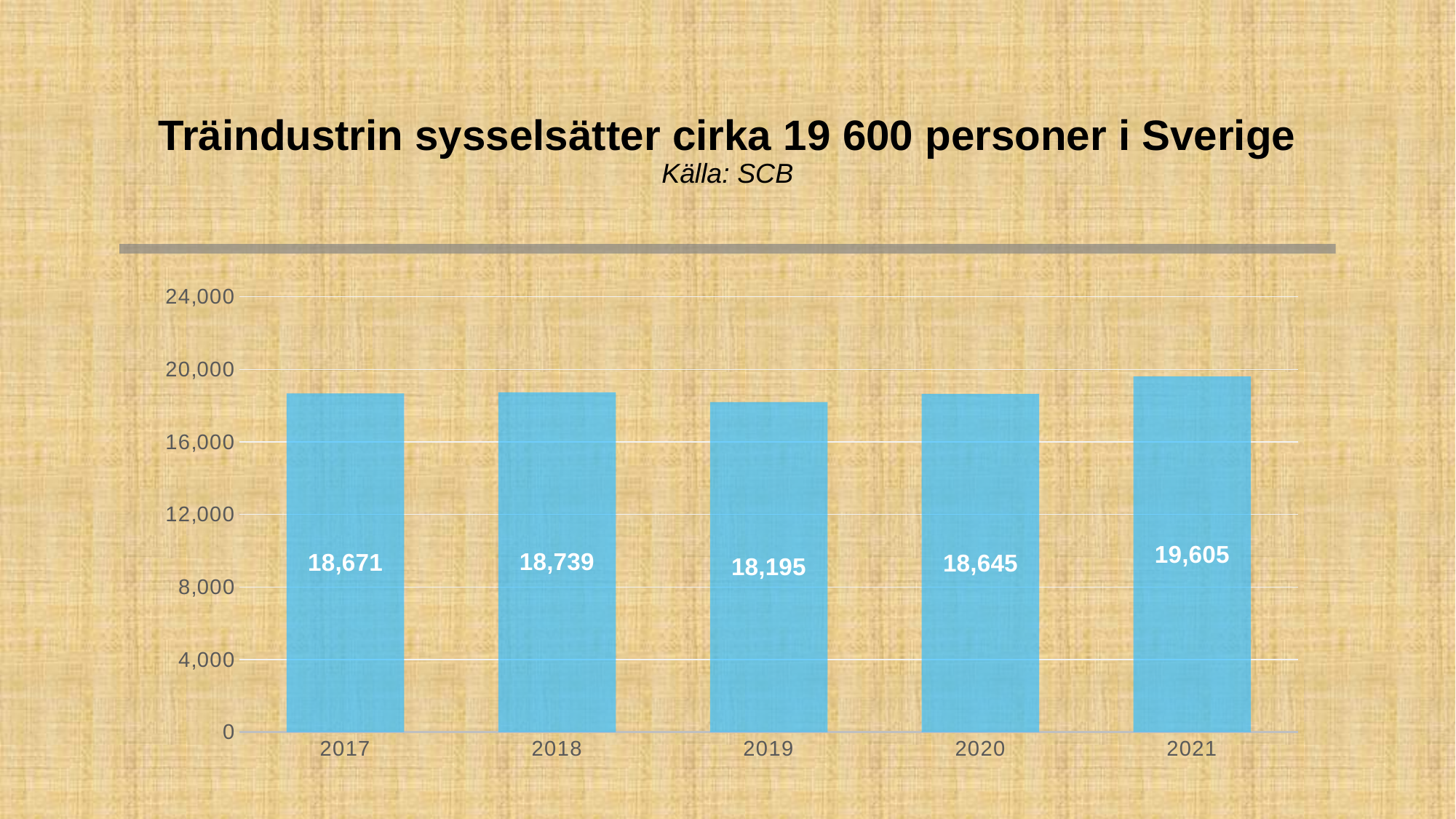
What is the source cited below the slide title? SCB What is the value for 2017? 18,671 What is the difference between the values for 2018 and 2017? 68 What is the difference between the values for 2021 and 2019? 1,410 How many years are shown on the x axis? 5 What kind of chart is shown on the slide? bar chart Is the value for 2019 greater or less than 20,000? less Which year has the lowest value? 2019 Which is larger, the value for 2020 or the value for 2021? 2021 Which year has the highest value? 2021 What is the value for 2021? 19,605 What is the value for 2019? 18,195